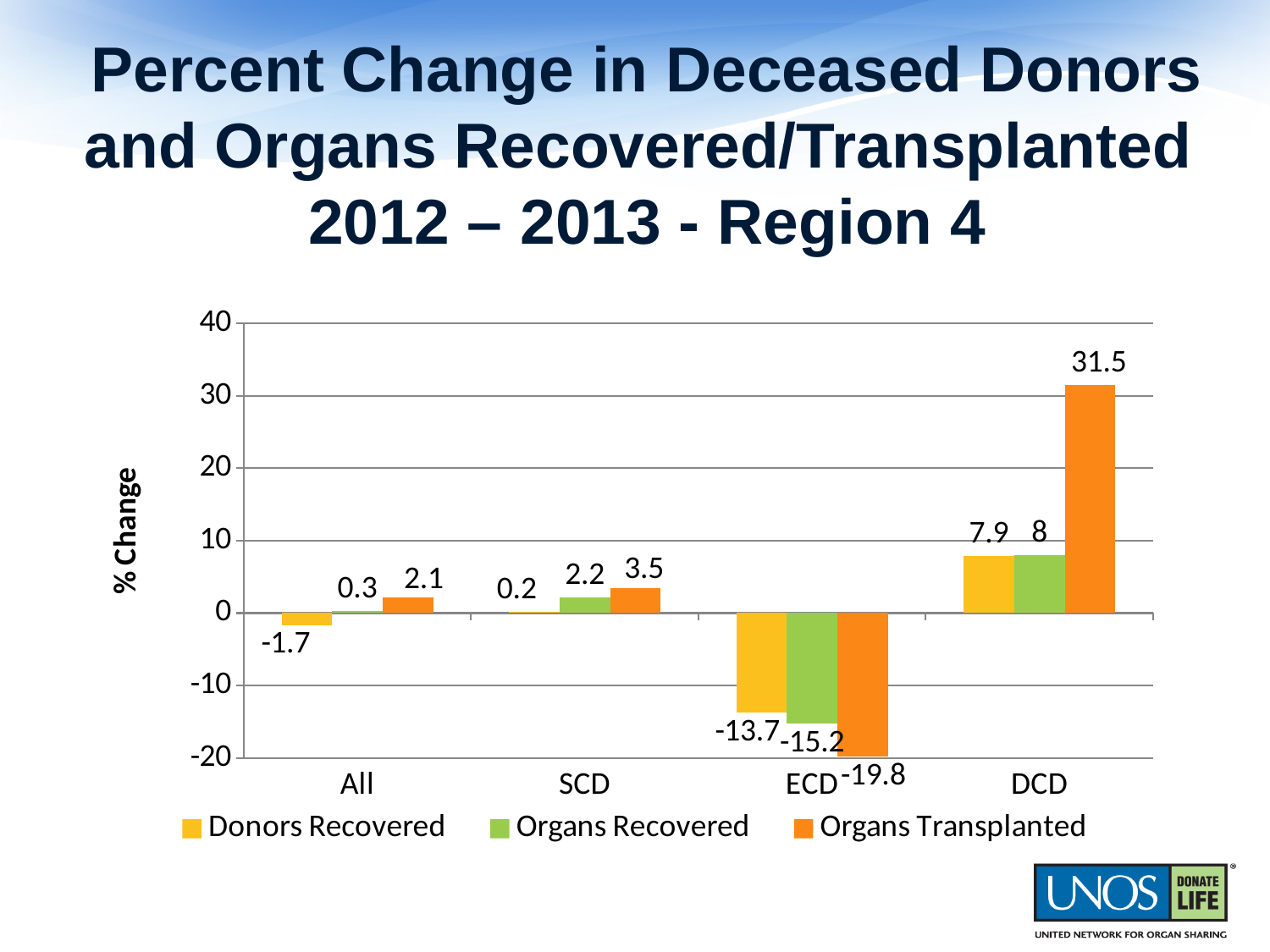
What kind of chart is shown on the slide? bar chart Which category has the lowest value for Organs Recovered? ECD Which category has the highest value for Organs Transplanted? DCD Which is larger in the SCD category: Organs Transplanted or Donors Recovered? Organs Transplanted What is the value for Organs Recovered in the SCD category? 2.2 What is the value for Donors Recovered in the ECD category? -13.7 How many categories are shown on the x axis? 4 Is the value for Organs Transplanted in the DCD category greater or less than 30? greater What is the value for Organs Transplanted in the DCD category? 31.5 What is the difference between Organs Transplanted and Donors Recovered in the DCD category? 23.6 What is the value for Donors Recovered in the All category? -1.7 How many series does the legend list? 3